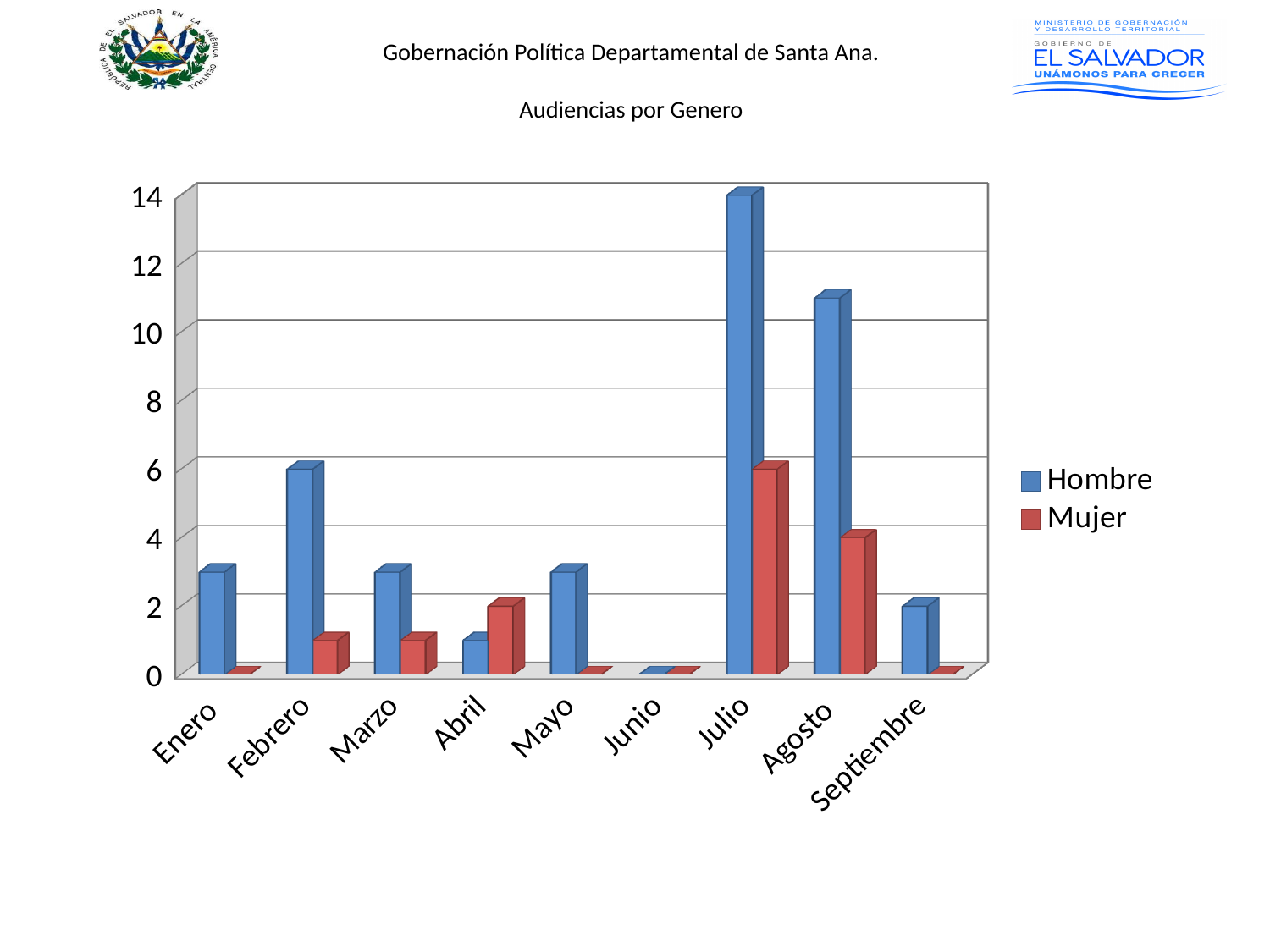
Which month has the highest Hombre value? Julio Which month has the highest Mujer value? Julio What are the two series named in the legend? Hombre and Mujer How many months are shown on the x axis? 9 Is the Hombre value for Agosto greater or less than 10? greater What is the title of the chart? Audiencias por Genero How many series does the legend list? 2 Which is larger in Abril, the Hombre value or the Mujer value? Mujer What kind of chart is shown on the slide? bar chart Is the Hombre value for Febrero greater or less than 4? greater Is the Mujer value for Agosto greater or less than 6? less Which is larger in Agosto, the Hombre value or the Mujer value? Hombre